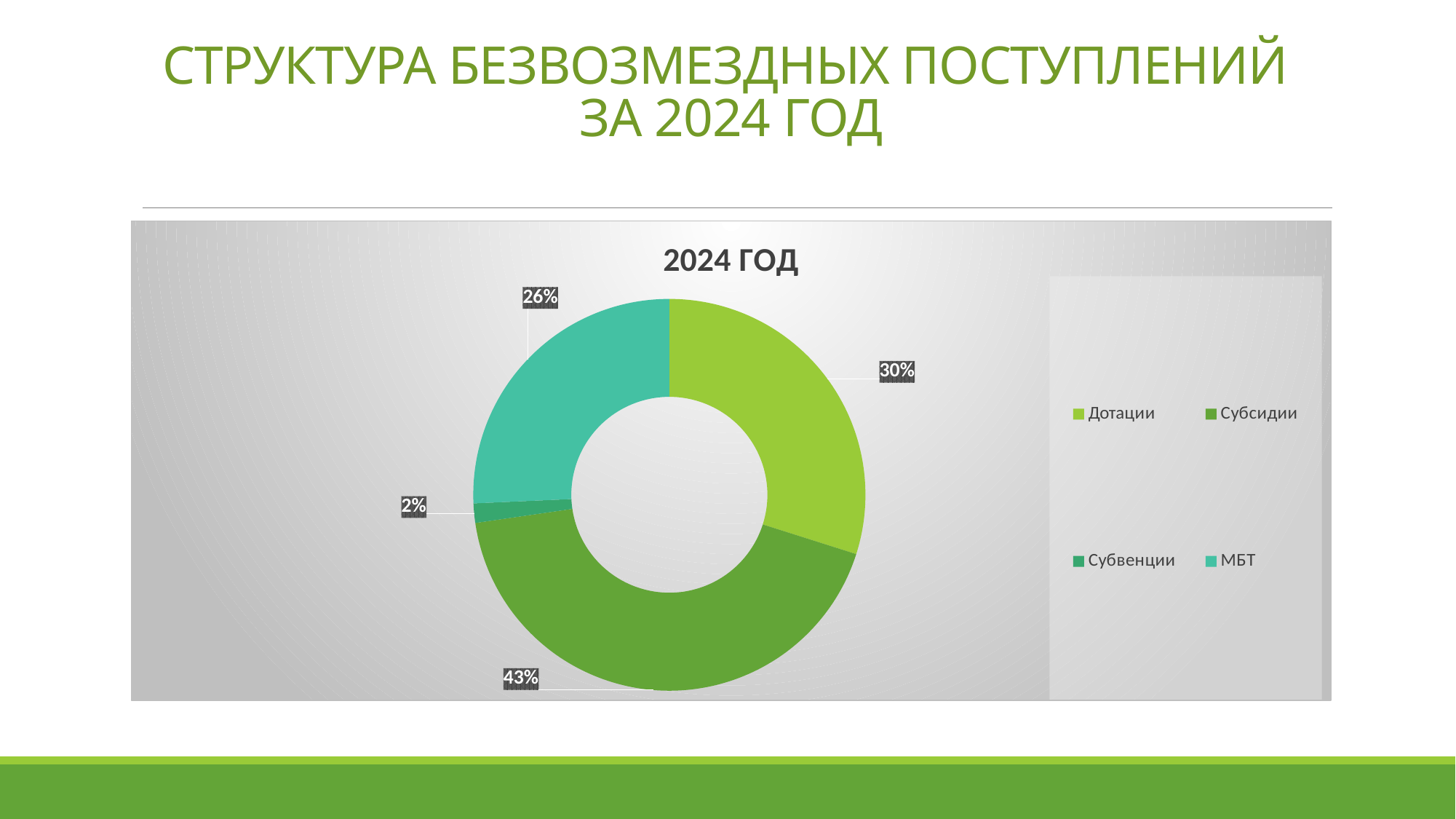
How many categories are shown in the chart? 4 What is the title of the chart? 2024 ГОД What share of the chart does Дотации represent? 30% What kind of chart is shown on the slide? Doughnut (pie) chart What is the difference in percentage points between Субсидии and Дотации? 13 What is the difference in percentage points between МБТ and Субвенции? 24 Which category has the smallest share? Субвенции What share of the chart does Субсидии represent? 43% What share of the chart does МБТ represent? 26% Which is larger, the share for Дотации or the share for МБТ? Дотации Which category has the largest share? Субсидии